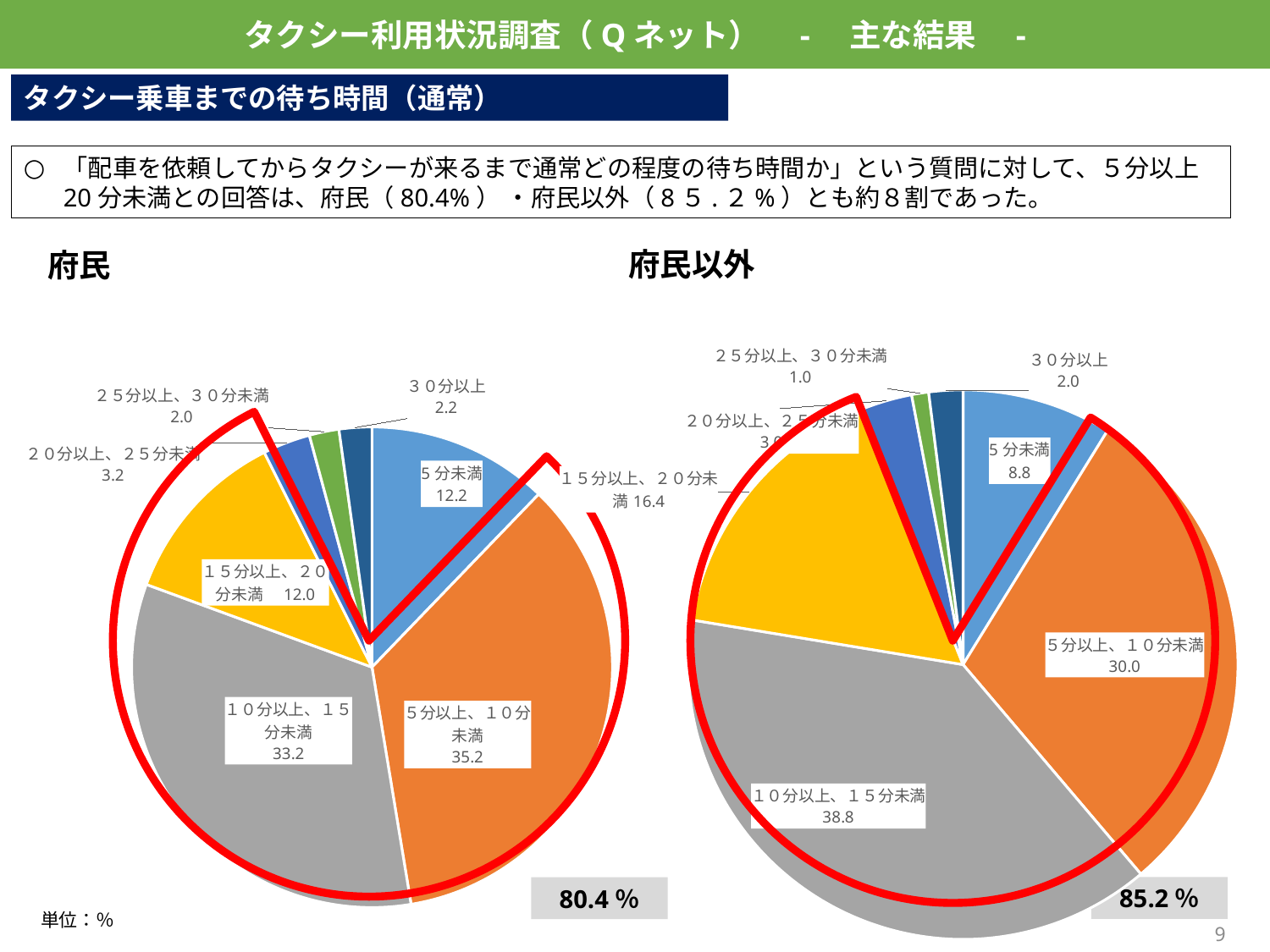
How many categories does the 府民 pie chart have? 7 In the 府民以外 pie chart, which category has the smallest share? 25分以上、30分未満 Which is larger: 5分未満 in the 府民 chart or 5分未満 in the 府民以外 chart? 府民 In the 府民 pie chart, what is the value for 5分未満? 12.2 In the 府民以外 pie chart, what is the value for 15分以上、20分未満? 16.4 In the 府民 pie chart, which category has the largest share? 5分以上、10分未満 What type of chart is used for 府民以外? pie chart In the 府民以外 pie chart, what is the difference between 10分以上、15分未満 and 5分以上、10分未満? 8.8 In the 府民以外 pie chart, what is the value for 10分以上、15分未満? 38.8 In the 府民 pie chart, what is the difference between 5分以上、10分未満 and 10分以上、15分未満? 2.0 In the 府民 pie chart, what is the value for 5分以上、10分未満? 35.2 What unit is indicated for the values in the charts? %